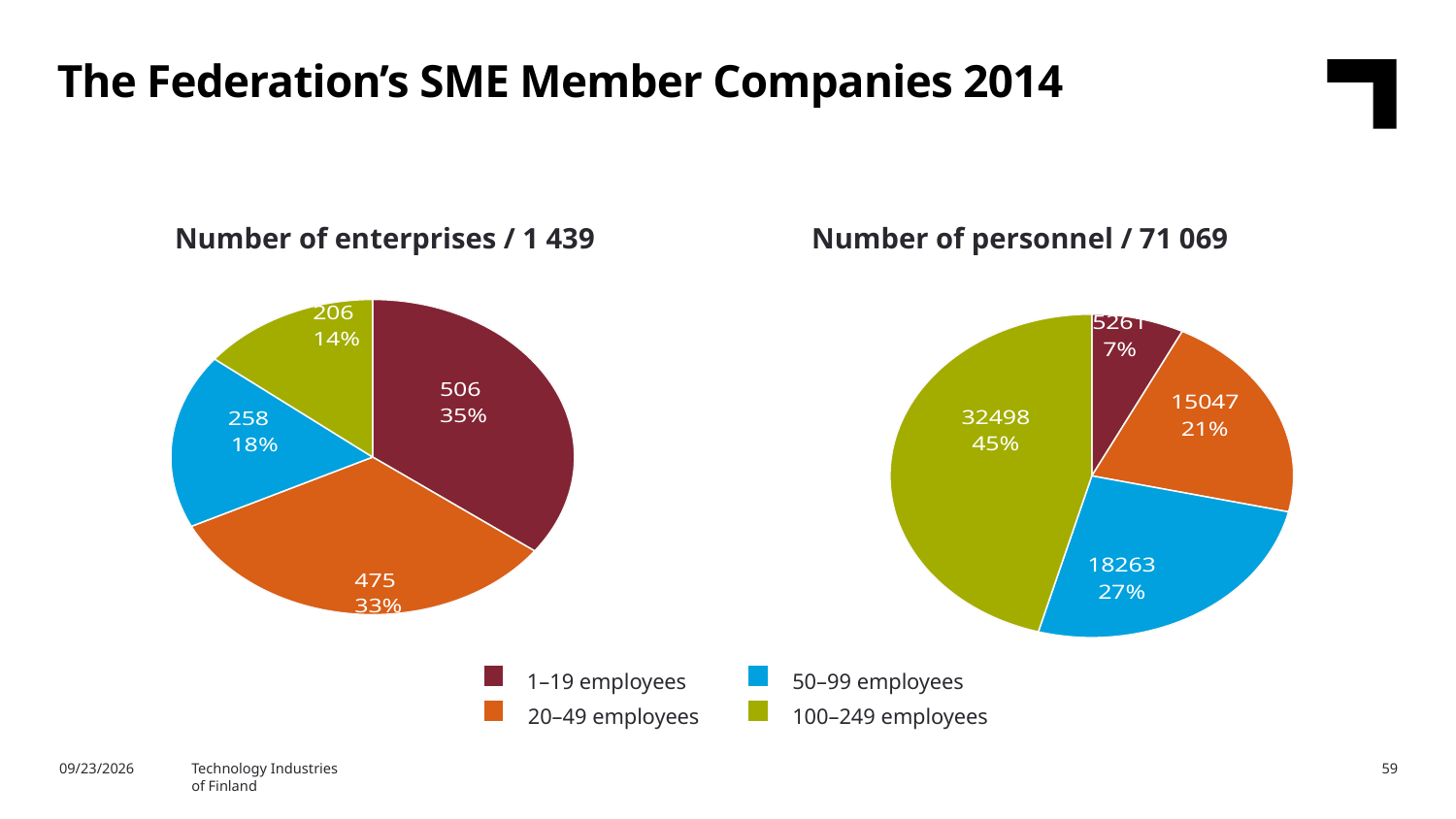
In the 'Number of personnel / 71 069' chart, which size category has the largest number of personnel? 100–249 employees In the 'Number of enterprises / 1 439' chart, what share of enterprises have 50–99 employees? 18% In the 'Number of personnel / 71 069' chart, which size category has the smallest number of personnel? 1–19 employees In the 'Number of enterprises / 1 439' chart, how many enterprises have 1–19 employees? 506 What kind of charts are shown on the slide? Pie charts In the 'Number of enterprises / 1 439' chart, which size category has the fewest enterprises? 100–249 employees In the 'Number of enterprises / 1 439' chart, what is the difference between the number of enterprises with 1–19 employees and those with 20–49 employees? 31 In the 'Number of enterprises / 1 439' chart, which has more enterprises: 50–99 employees or 100–249 employees? 50–99 employees How many categories does the legend list? 4 In the 'Number of personnel / 71 069' chart, what is the difference in personnel between the 50–99 employees and 20–49 employees categories? 3216 In the 'Number of personnel / 71 069' chart, what share of personnel is in companies with 20–49 employees? 21% In the 'Number of personnel / 71 069' chart, how many personnel are in companies with 100–249 employees? 32498